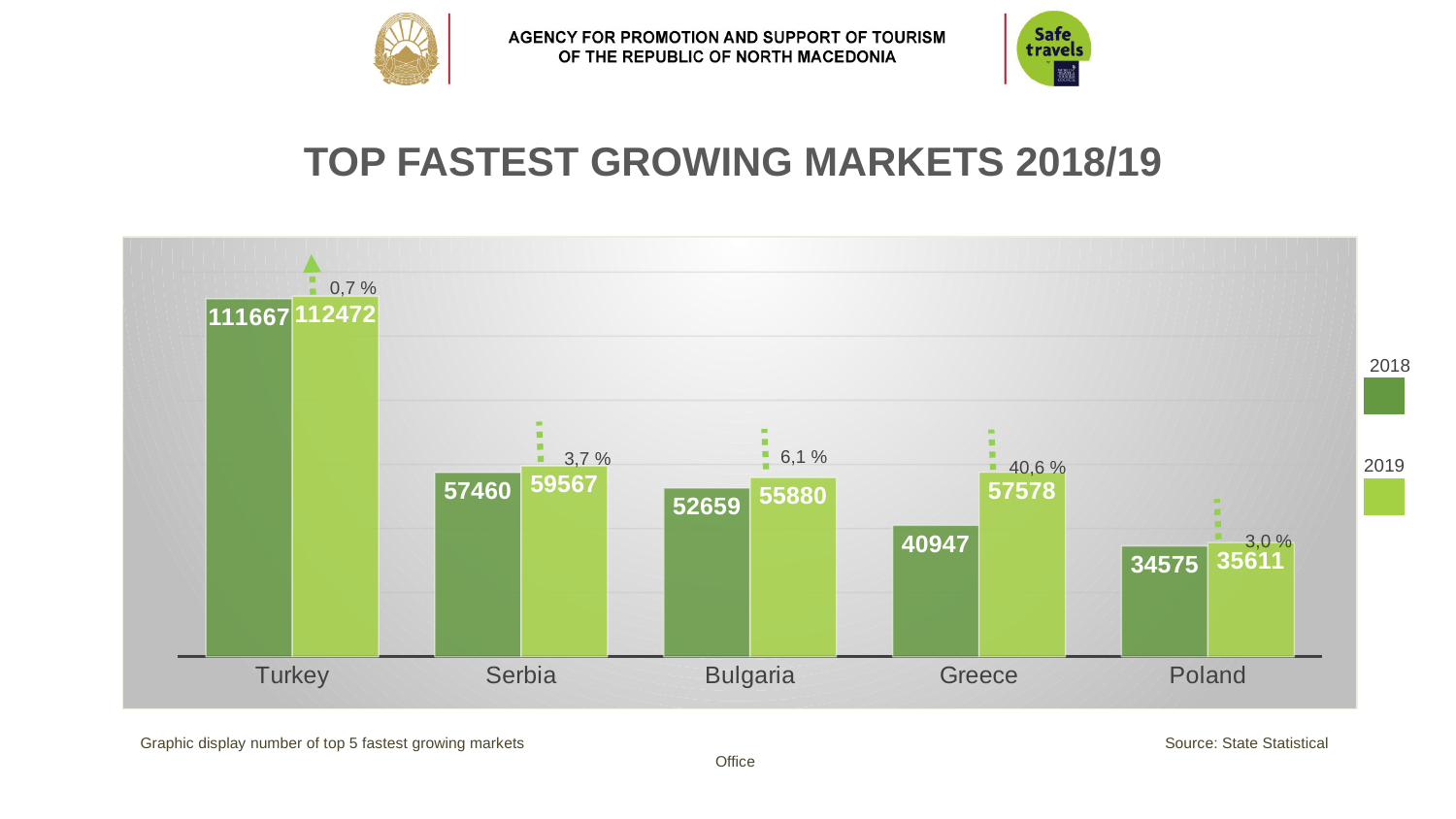
What is the 2018 value for Greece? 40947 How many series does the legend list? 2 What is the difference between the 2019 and 2018 values for Greece? 16631 What type of chart is shown on the slide? Bar chart How many markets are shown on the x axis? 5 Which is larger, the 2019 value for Serbia or the 2019 value for Greece? Serbia What is the 2019 value for Bulgaria? 55880 What is the 2019 value for Poland? 35611 What is the difference between the 2019 and 2018 values for Serbia? 2107 Which market has the lowest 2018 value? Poland What growth percentage is annotated above the Greece bars? 40,6 % Which market has the highest 2019 value? Turkey